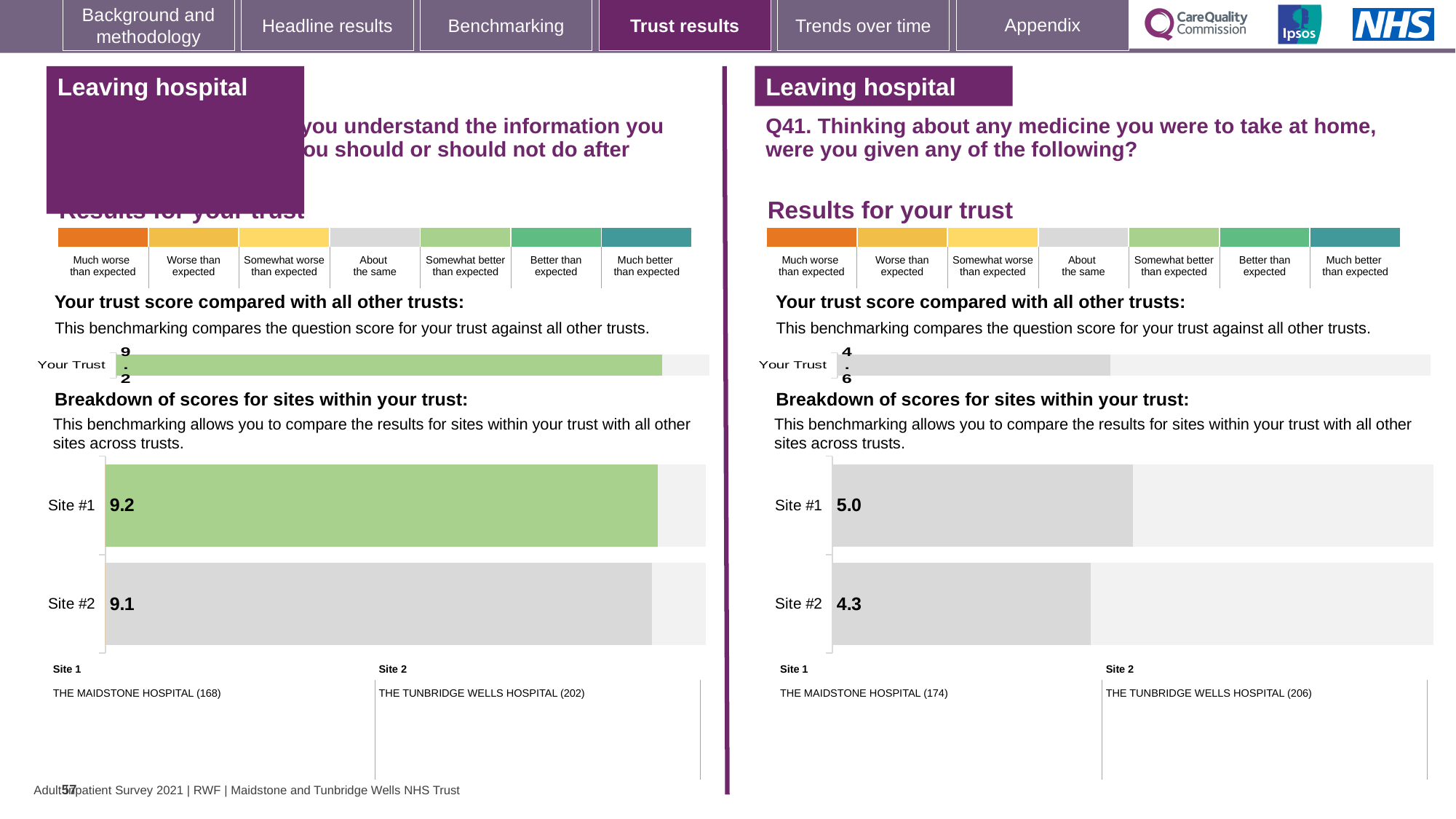
On the left-hand site breakdown chart, what is the score for Site #2? 9.1 On the right-hand site breakdown chart (Q41), what is the difference between the Site #1 and Site #2 scores? 0.7 On the right-hand site breakdown chart (Q41), what is the score for Site #2? 4.3 On the right-hand site breakdown chart (Q41), what is the score for Site #1? 5.0 On the left-hand site breakdown chart, what is the difference between the Site #1 and Site #2 scores? 0.1 On the left-hand site breakdown chart, what is the score for Site #1? 9.2 How many sites are shown in the site breakdown chart on the right-hand side (Q41)? 2 On the right-hand chart (Q41), what is the score shown for Your Trust? 4.6 On the left-hand chart, what colour is the Your Trust bar? Green What type of chart is used for the site breakdown on the left-hand side of the slide? Bar chart On the right-hand site breakdown chart (Q41), which site has the higher score? Site #1 On the left-hand chart, what is the score shown for Your Trust? 9.2